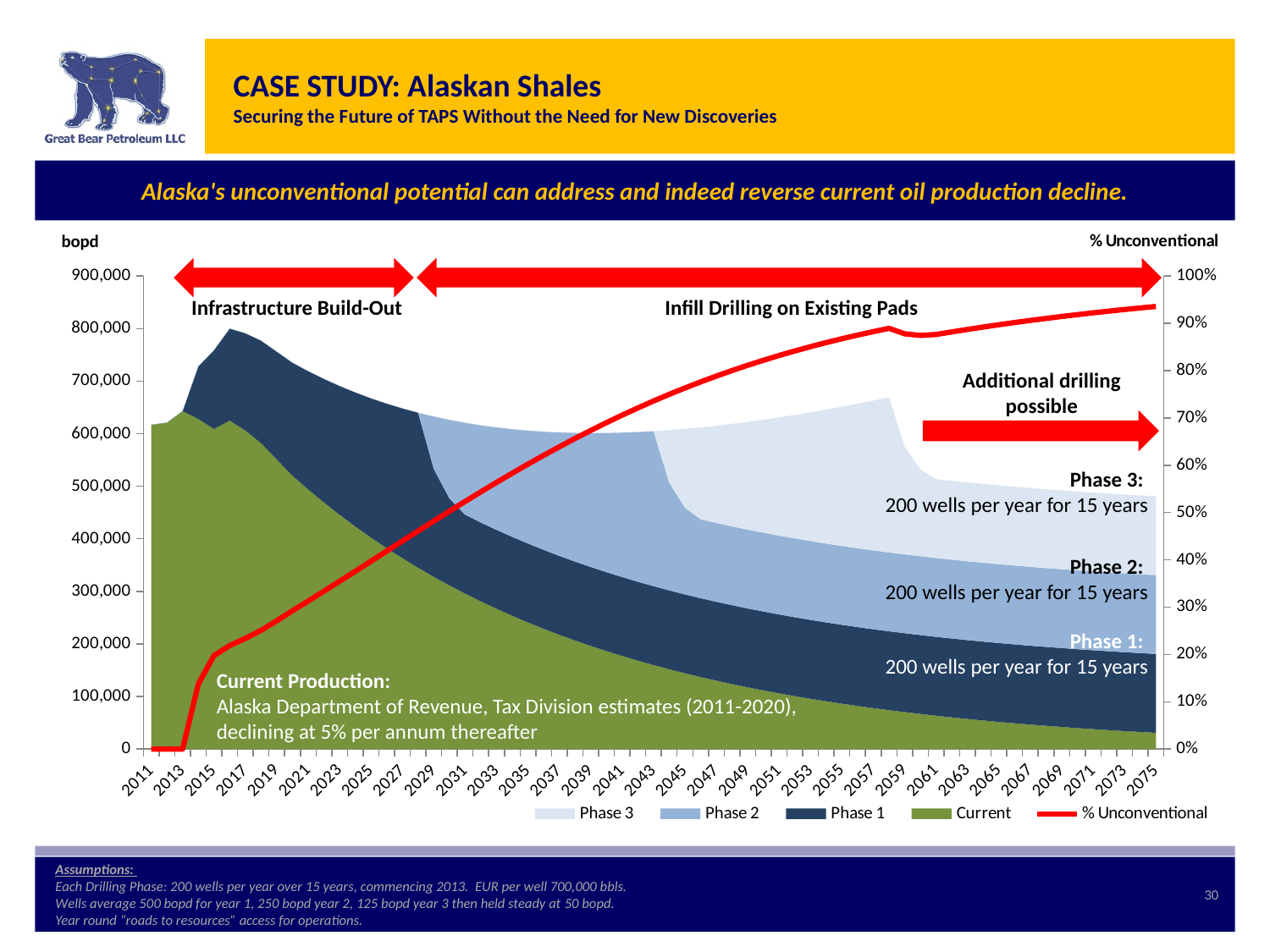
Is the % Unconventional value in 2059 greater or less than 80%? greater Is the Current production value in 2011 greater or less than 500,000 bopd? greater How many year labels are shown on the x axis of the chart? 33 What is the % Unconventional value in 2011? 0% What unit is shown on the left vertical axis of the chart? bopd Is the % Unconventional value in 2075 greater or less than 90%? greater Does the % Unconventional line rise or fall from 2013 to 2075? Rises How many series does the chart legend list? 5 What kind of chart is shown on the slide? A stacked area chart combined with a line chart Which series in the legend is plotted as a line rather than an area? % Unconventional Does the Current production area rise or fall from 2017 to 2075? Falls